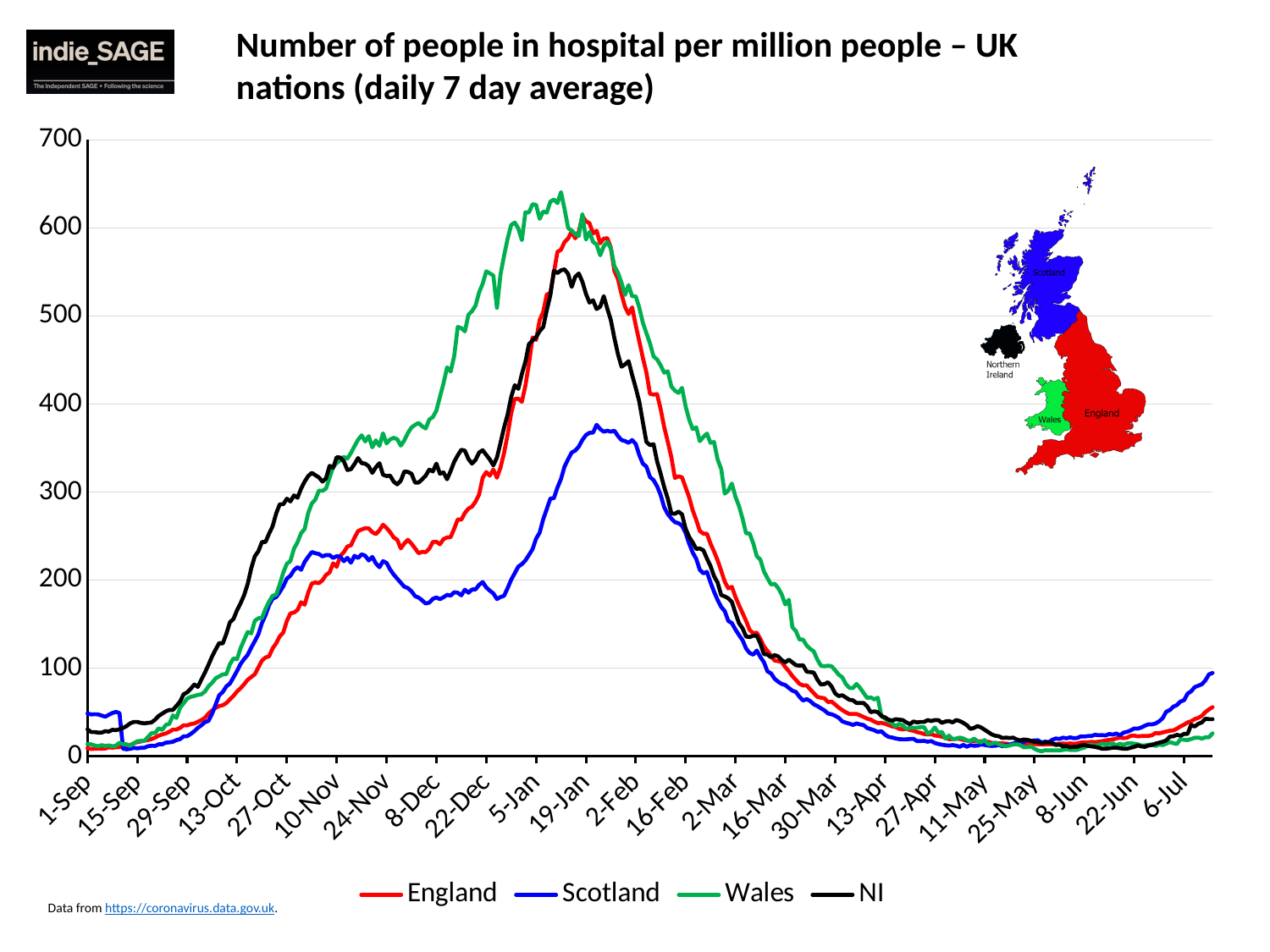
Is the peak value for NI greater or less than 500? greater Between 19-Jan and 11-May, does the England line rise or fall? fall Around 8-Dec, which is higher, the Wales line or the Scotland line? Wales Which colour is used for the Scotland line? blue Which nation's line reaches the highest peak on the chart? Wales What kind of chart is shown on the slide? line chart Is the peak value for Scotland greater or less than 400? less How many series does the legend list? 4 Around 10-Nov, which is higher, the NI line or the England line? NI What is the title of the chart? Number of people in hospital per million people – UK nations (daily 7 day average) Is the peak value for Wales greater or less than 600? greater Which nation's line has the lowest peak on the chart? Scotland